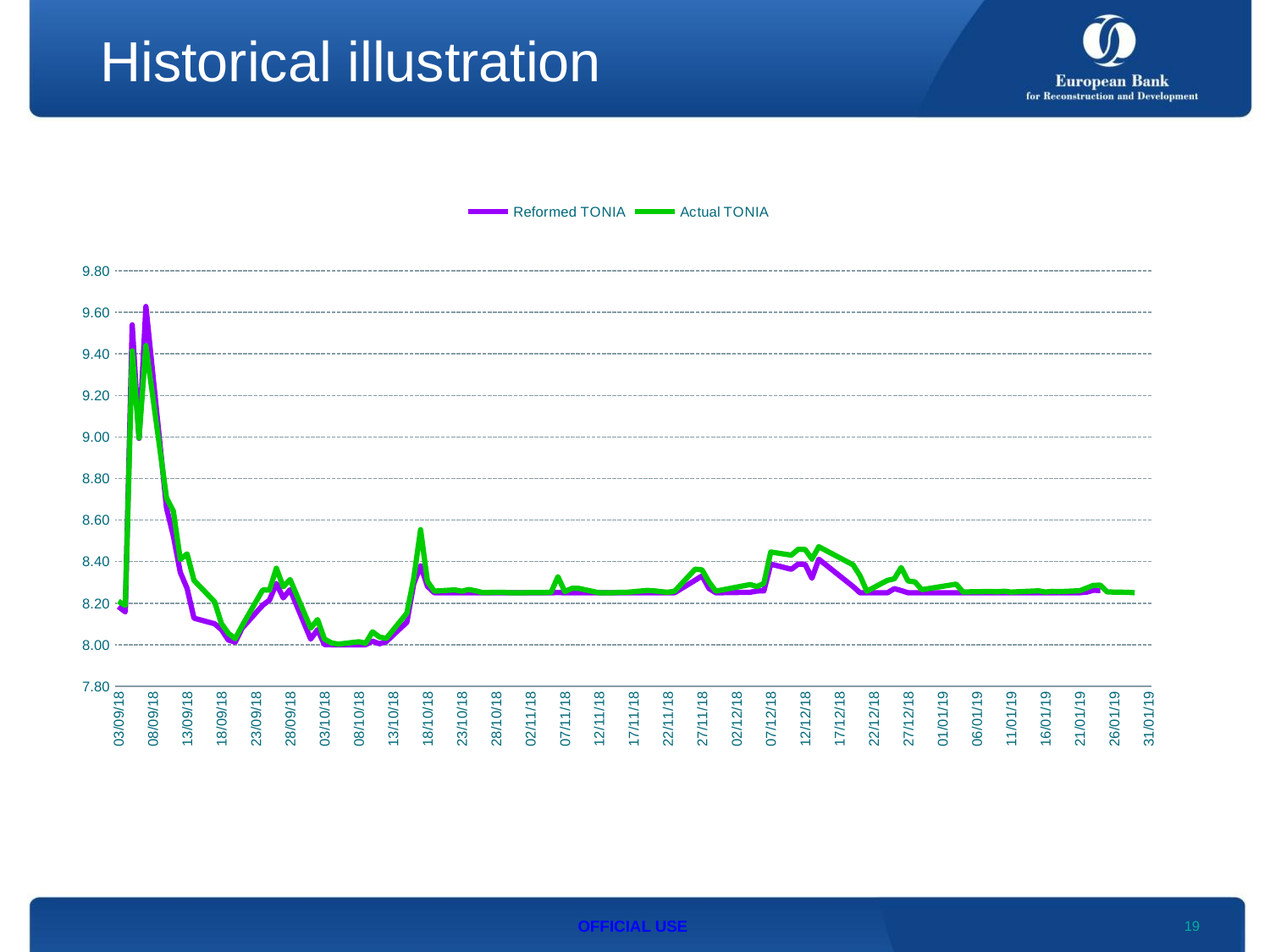
What kind of chart is shown on the slide? line chart Is the value of Actual TONIA at its spike around 18/10/18 greater or less than 8.40? greater Around 12/12/18, which series has the higher value, Reformed TONIA or Actual TONIA? Actual TONIA Is the value of Reformed TONIA around 03/10/18 greater or less than 8.20? less Which colour is used for the Actual TONIA line? green Is the peak value of Reformed TONIA in early September 2018 greater or less than 9.40? greater What are the two series named in the legend? Reformed TONIA and Actual TONIA Do the values of Actual TONIA rise or fall between 08/09/18 and 18/09/18? fall How many series does the legend list? 2 Around 18/10/18, which series has the higher value, Reformed TONIA or Actual TONIA? Actual TONIA